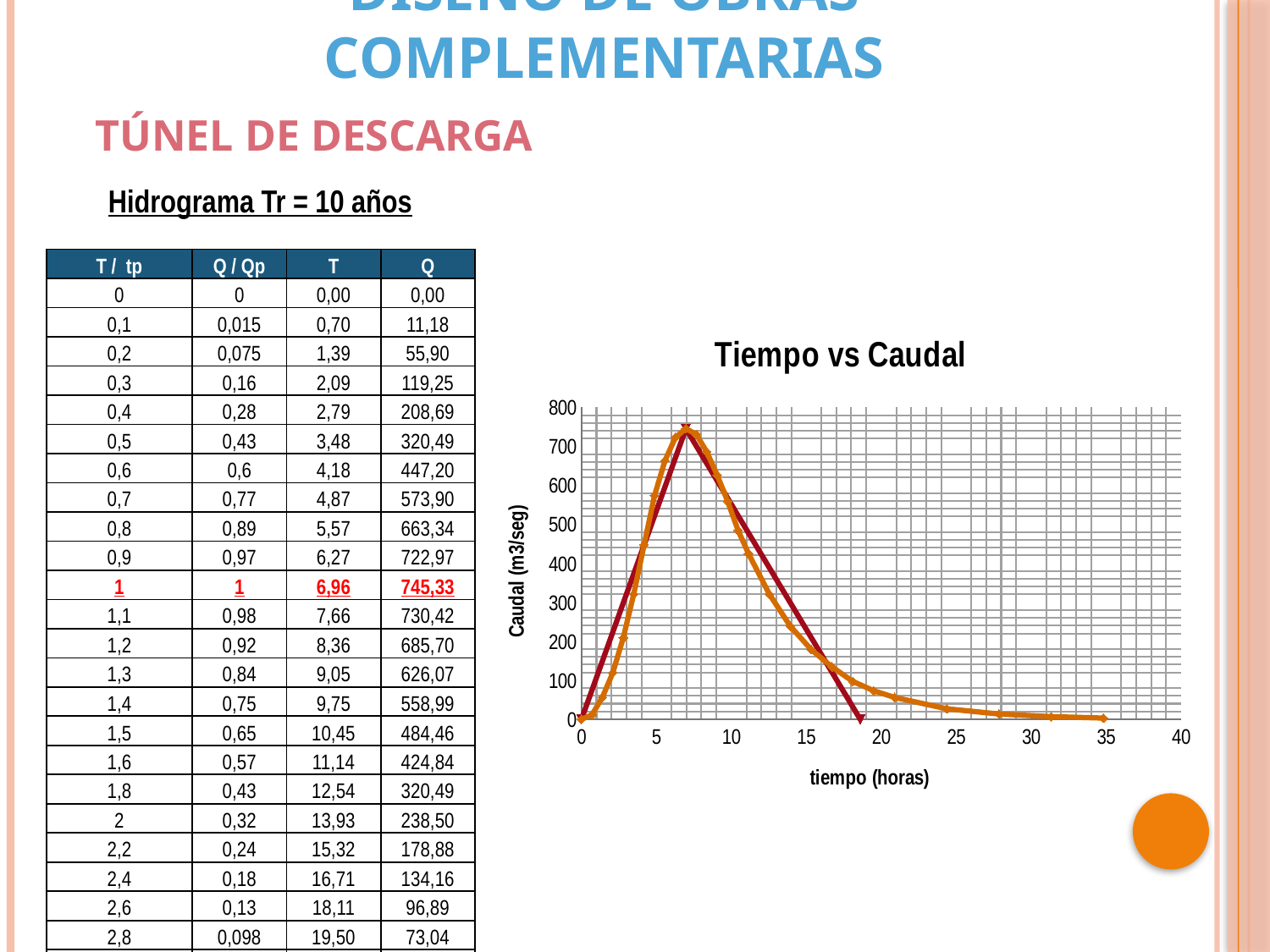
What kind of chart is "Tiempo vs Caudal"? line chart What is the title of the chart? Tiempo vs Caudal Do the values of the orange curve rise or fall between 10 and 30 horas? fall Which is larger on the orange curve: the value at 5 horas or the value at 15 horas? 5 horas Is the value of the orange curve at 15 horas greater or less than 100? greater What is the label of the y axis of the chart? Caudal (m3/seg) Is the peak value of the orange curve greater or less than 700? greater Do the values of the orange curve rise or fall between 0 and 5 horas? rise Is the value of the orange curve at 5 horas greater or less than 500? greater